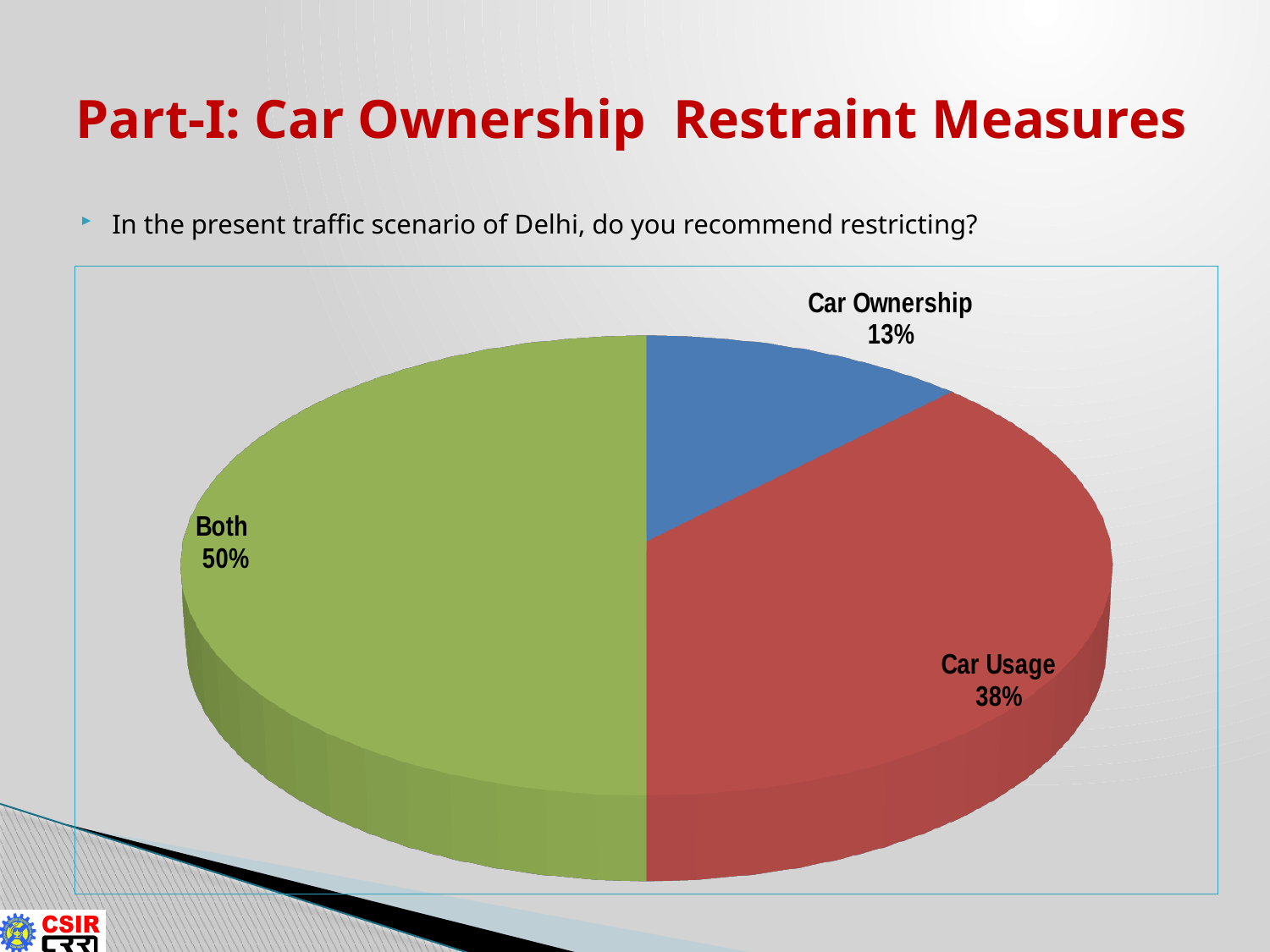
What share of the pie is labelled Both? 50% What is the difference in percentage points between the Both slice and the Car Usage slice? 12 Which slice of the pie is the smallest? Car Ownership What share of the pie is labelled Car Ownership? 13% What colour is the Both slice of the pie? green Which slice of the pie is the largest? Both What colour is the Car Usage slice of the pie? red Which is larger, the Car Usage slice or the Car Ownership slice? Car Usage What share of the pie is labelled Car Usage? 38% What is the difference in percentage points between the Car Usage slice and the Car Ownership slice? 25 What kind of chart is shown on the slide? pie chart How many slices does the pie chart have? 3